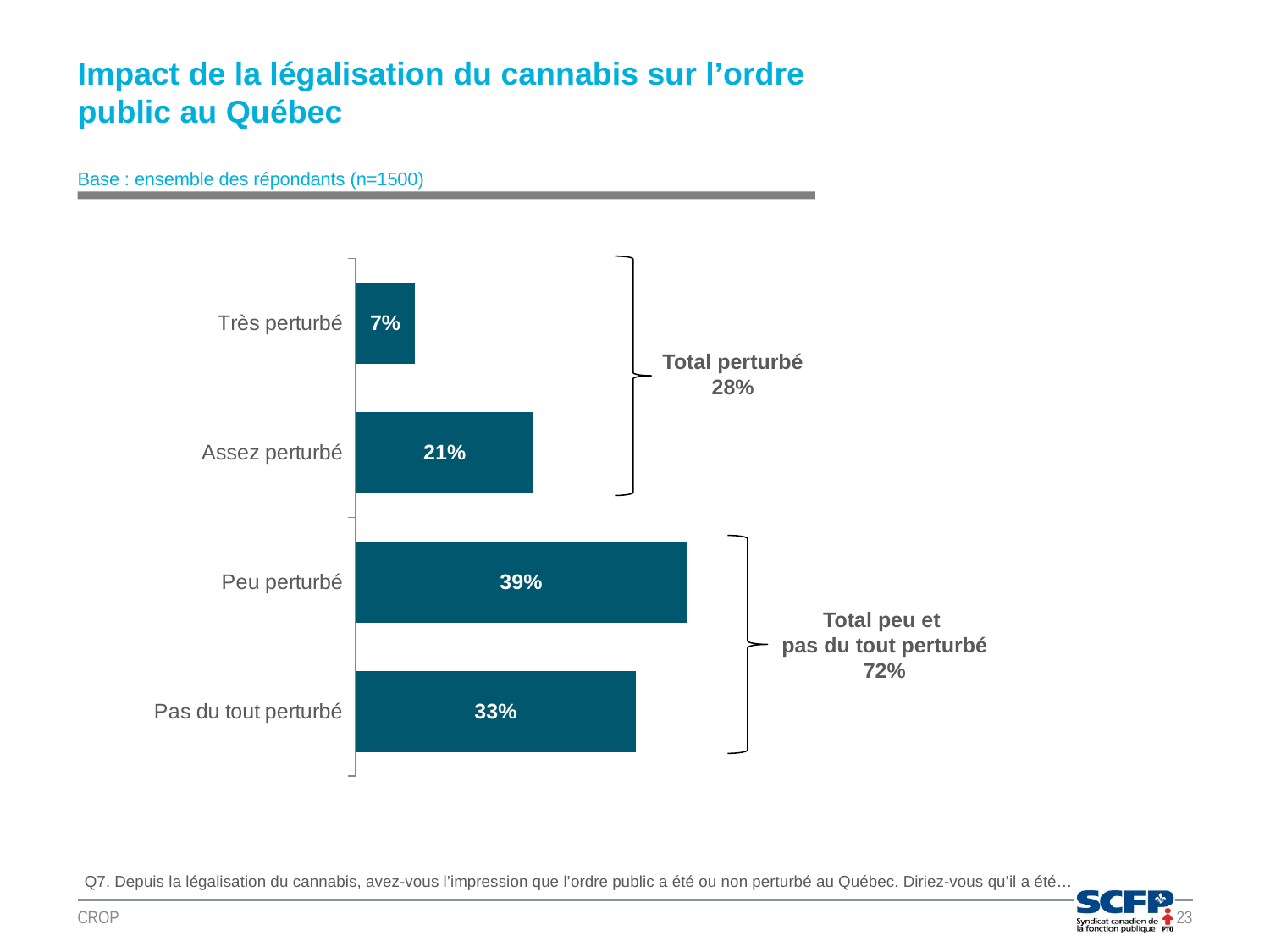
What is the combined percentage shown for "Total perturbé"? 28% What percentage of respondents answered "Assez perturbé"? 21% What kind of chart is shown on the slide? Bar chart What percentage of respondents answered "Très perturbé"? 7% What percentage of respondents answered "Pas du tout perturbé"? 33% Which is larger, the value for "Assez perturbé" or the value for "Pas du tout perturbé"? Pas du tout perturbé What percentage of respondents answered "Peu perturbé"? 39% How many response categories are shown in the chart? 4 Which response category has the lowest percentage? Très perturbé Which response category has the highest percentage? Peu perturbé What is the difference in percentage points between "Peu perturbé" and "Pas du tout perturbé"? 6 What is the combined percentage shown for "Total peu et pas du tout perturbé"? 72%